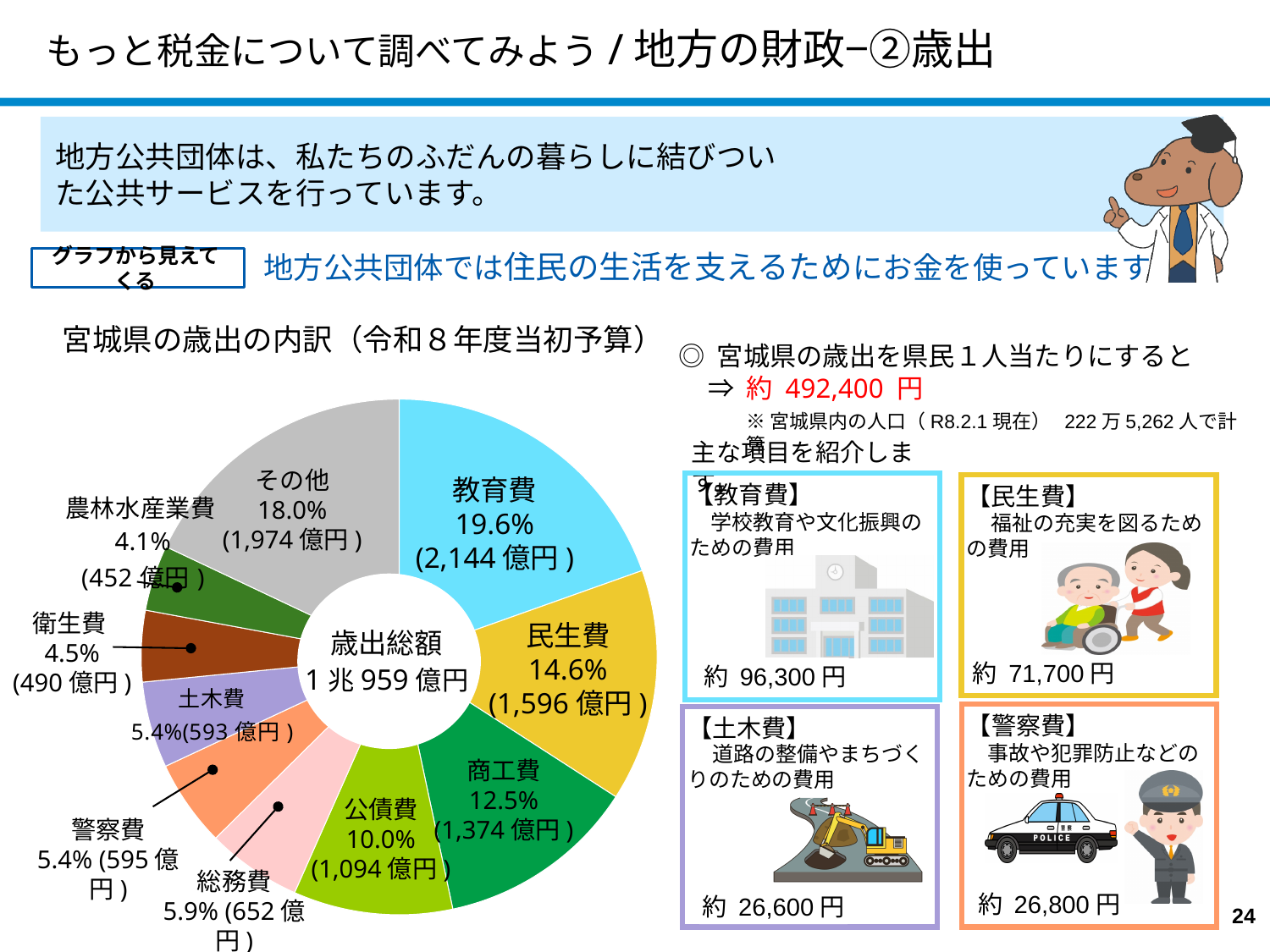
円グラフで、教育費の割合は何%ですか。 19.6% 円グラフで、教育費と民生費の割合の差は何ポイントですか。 5.0ポイント 円グラフで、商工費の割合は何%ですか。 12.5% このスライドのグラフはどの種類のグラフですか。 円グラフ 円グラフの中央に示されている歳出総額はいくらですか。 1兆959億円 円グラフのタイトルは何ですか。 宮城県の歳出の内訳（令和８年度当初予算） 円グラフで、最も割合が大きい項目はどれですか。 教育費 円グラフで、最も割合が小さい項目はどれですか。 農林水産業費 円グラフには項目がいくつありますか。 10 円グラフで、民生費の金額はいくらですか。 1,596億円 円グラフで、公債費と総務費ではどちらの割合が大きいですか。 公債費 円グラフで、衛生費の金額はいくらですか。 490億円